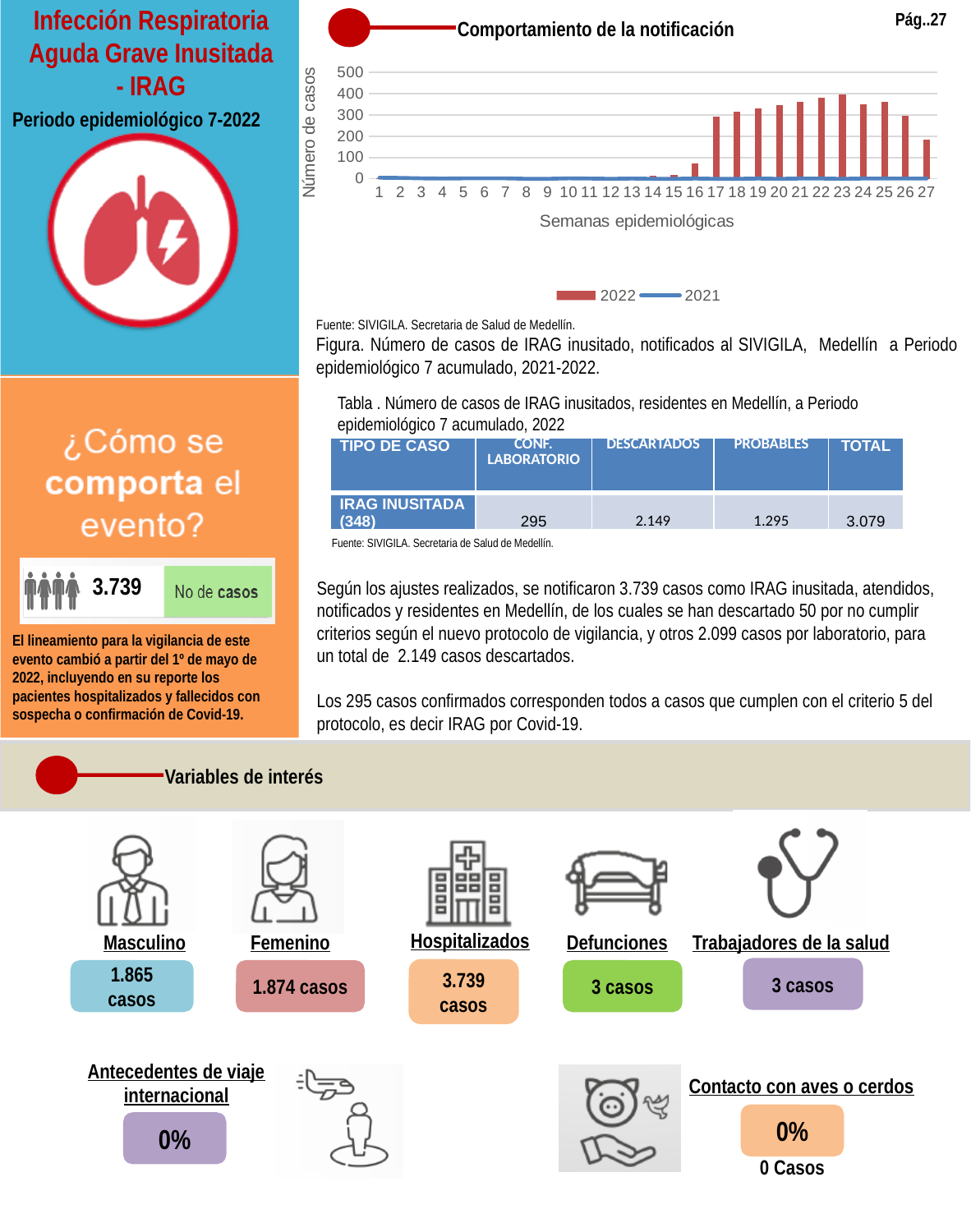
In the 'Comportamiento de la notificación' chart, is the 2022 value for week 17 greater or less than 400? less What kind of chart is shown under 'Comportamiento de la notificación'? bar chart (with a line for 2021) What is the label of the y axis in the 'Comportamiento de la notificación' chart? Número de casos In the 'Comportamiento de la notificación' chart, which series is shown in red? 2022 In the 'Comportamiento de la notificación' chart, which is larger for 2022: week 16 or week 17? week 17 In the 'Comportamiento de la notificación' chart, is the 2022 value for week 16 greater or less than 100? less In the 'Comportamiento de la notificación' chart, is the 2022 value for week 23 greater or less than 300? greater How many series does the legend of the 'Comportamiento de la notificación' chart list? 2 How many epidemiological weeks are shown on the x axis of the 'Comportamiento de la notificación' chart? 27 In the 'Comportamiento de la notificación' chart, do the 2022 values rise or fall from week 16 to week 23? rise In the 'Comportamiento de la notificación' chart, which week has the highest number of 2022 cases? 23